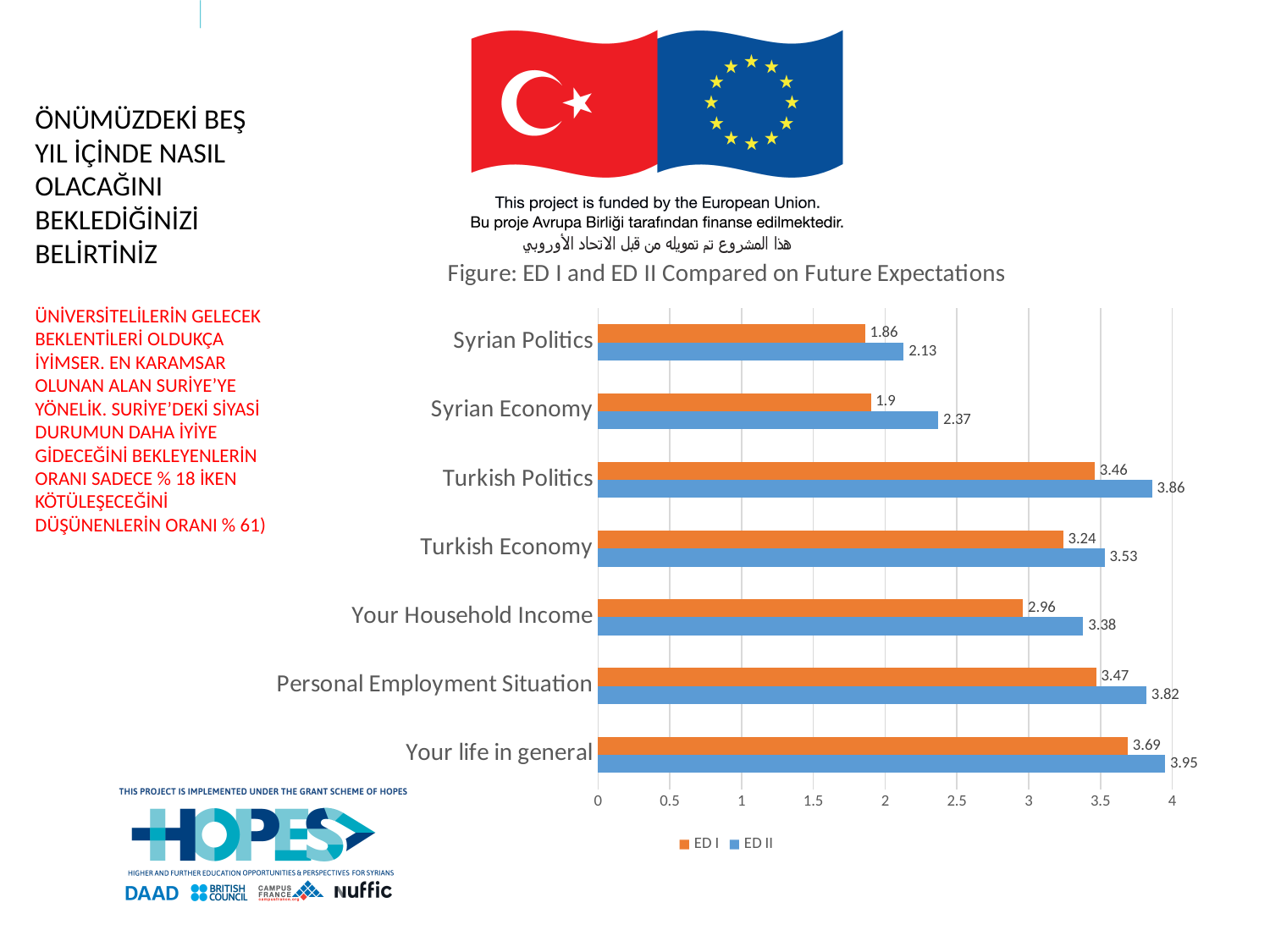
What is the difference between the ED II and ED I values for Syrian Economy? 0.47 What is the ED II value for Your Household Income? 3.38 How many categories are shown on the chart? 7 What is the ED II value for Turkish Economy? 3.53 What kind of chart is shown on the slide? Bar chart What is the ED I value for Syrian Politics? 1.86 Is the ED I value for Your Household Income greater or less than 3? less How many series does the legend list? 2 Which category has the lowest ED I value? Syrian Politics Which category has the highest ED II value? Your life in general What is the title of the chart? Figure: ED I and ED II Compared on Future Expectations Which is larger for Turkish Politics, the ED I value or the ED II value? ED II